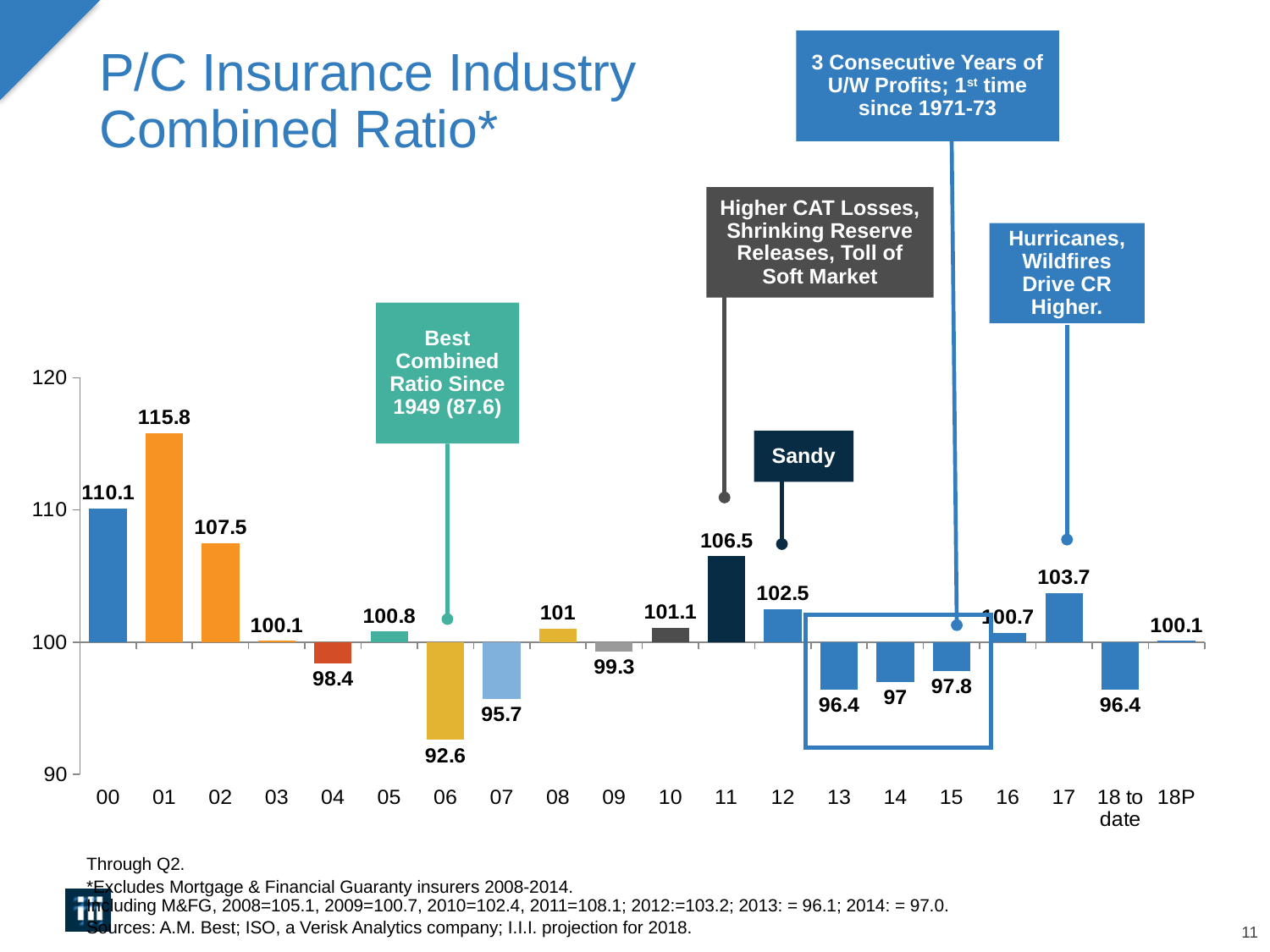
How many categories (years/periods) are shown on the x axis? 20 What is the difference between the combined ratio for 11 and the combined ratio for 12? 4 What kind of chart is shown on the slide? Bar chart What is the title of the chart on the slide? P/C Insurance Industry Combined Ratio* What is the difference between the combined ratio for 01 and the combined ratio for 00? 5.7 What is the combined ratio value shown for 2011 (labelled "11")? 106.5 What is the combined ratio value shown for 2006 (labelled "06")? 92.6 What is the combined ratio value shown for 2017 (labelled "17")? 103.7 Which year has the lowest combined ratio on the chart? 06 Which year has the highest combined ratio on the chart? 01 Is the combined ratio for 07 greater or less than 100? less Which is larger, the combined ratio for 17 or for 12? 17